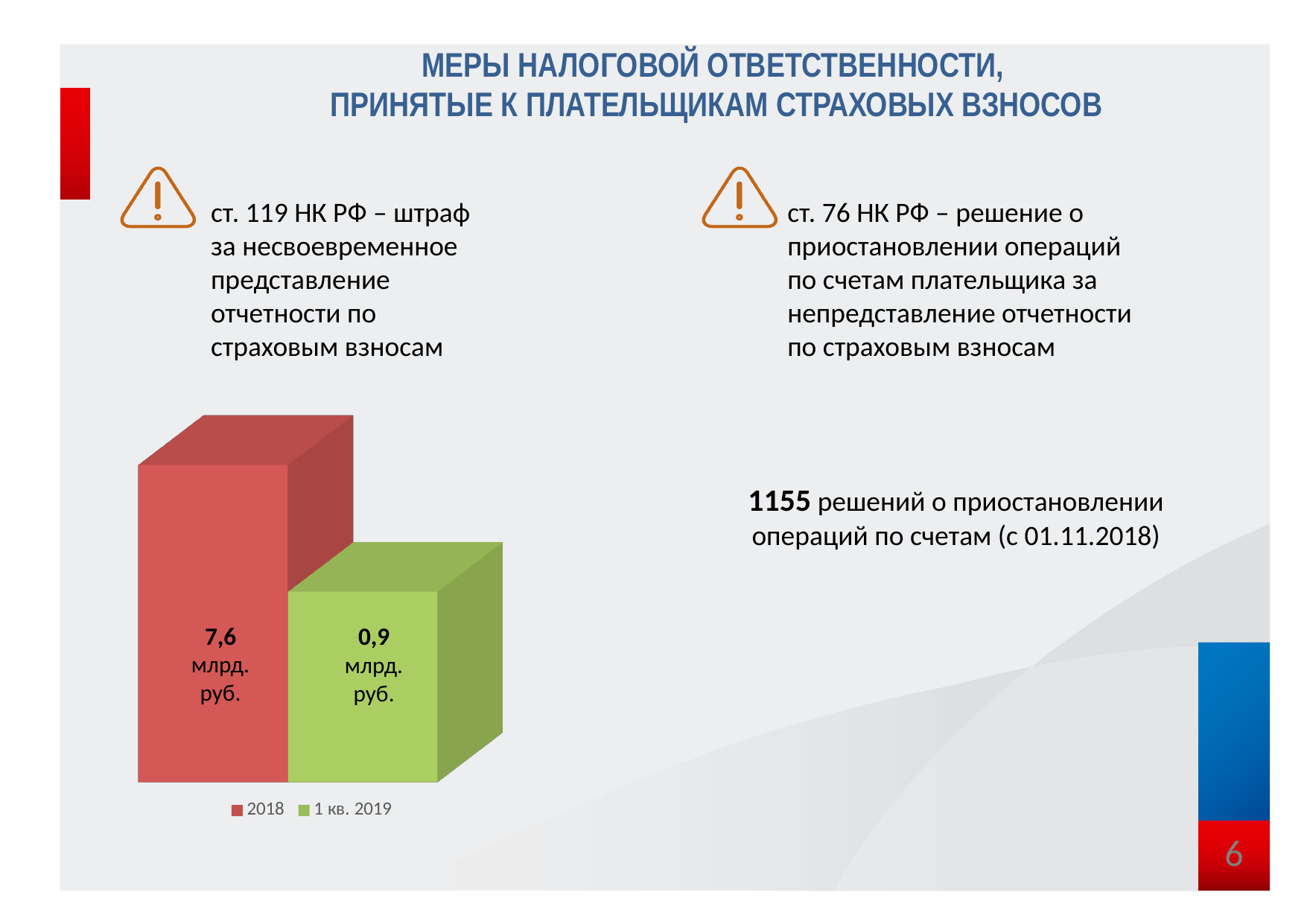
What value is shown for the 1 кв. 2019 bar in the chart? 0,9 млрд. руб. What is the combined total of the two bars in the chart? 8,5 млрд. руб. How many entries does the chart's legend list? 2 What is the difference between the 2018 value and the 1 кв. 2019 value in the chart? 6,7 млрд. руб. Which bar in the chart is the lowest? 1 кв. 2019 What kind of chart is shown on the slide? bar chart Do the values in the chart rise or fall from the 2018 bar to the 1 кв. 2019 bar? fall What value is shown for the 2018 bar in the chart? 7,6 млрд. руб. How many bars are plotted in the chart? 2 Which bar in the chart is the highest? 2018 What colour is the 2018 bar in the chart? red Which is larger in the chart: the value for 2018 or the value for 1 кв. 2019? 2018